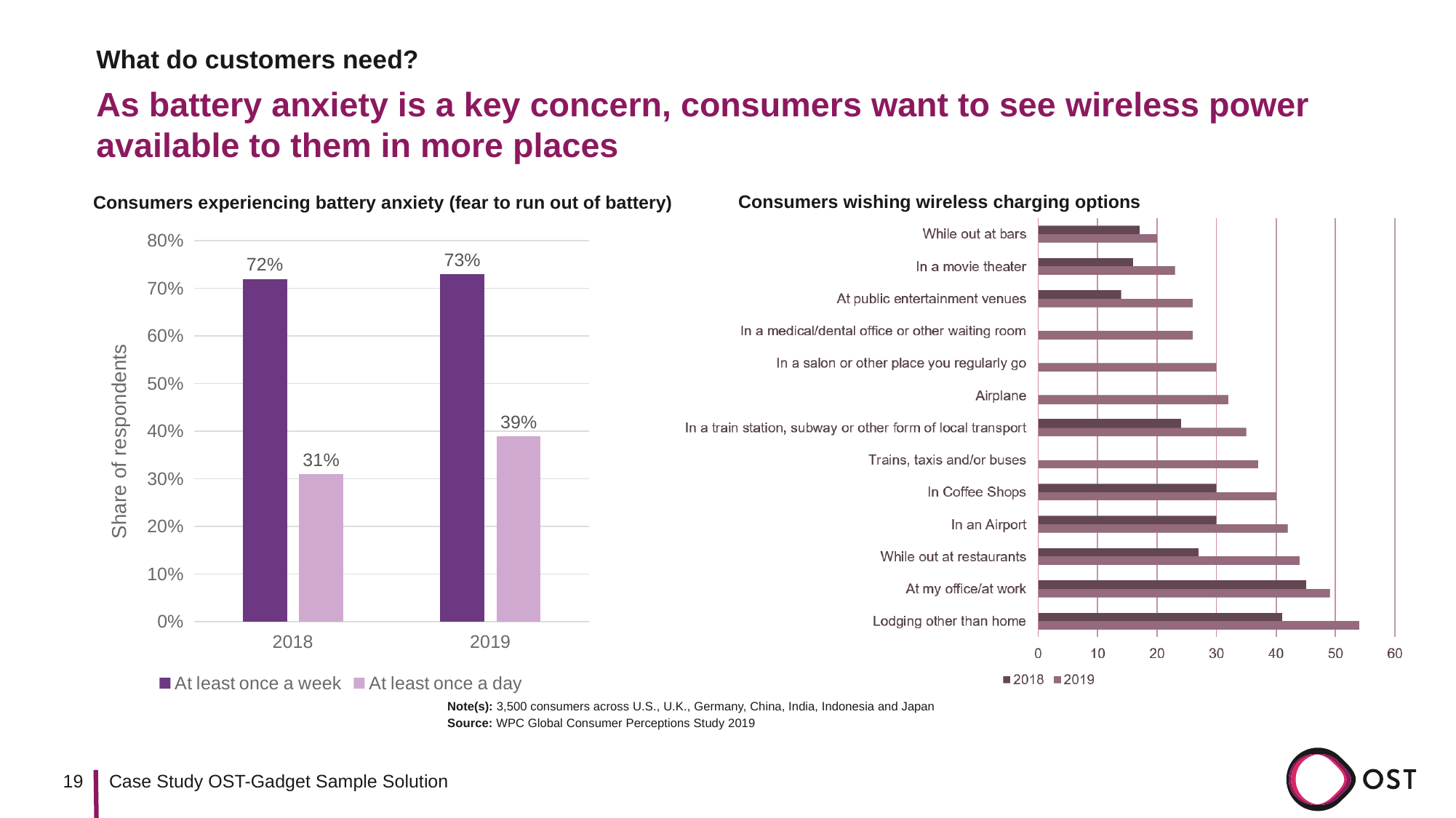
In the 'Consumers experiencing battery anxiety' chart, what is the value for 'At least once a week' in 2018? 72% What kind of chart is 'Consumers wishing wireless charging options'? Bar chart In the 'Consumers experiencing battery anxiety' chart, what is the value for 'At least once a day' in 2019? 39% In the 'Consumers experiencing battery anxiety' chart, what is the label of the vertical axis? Share of respondents In the 'Consumers wishing wireless charging options' chart, is the 2018 value for 'While out at bars' greater or less than 20? less In the 'Consumers wishing wireless charging options' chart, how many categories are shown? 13 In the 'Consumers experiencing battery anxiety' chart, which series has the higher value in 2019? At least once a week In the 'Consumers experiencing battery anxiety' chart, how many series does the legend list? 2 In the 'Consumers experiencing battery anxiety' chart, what is the difference between 'At least once a week' and 'At least once a day' in 2018? 41 percentage points In the 'Consumers wishing wireless charging options' chart, which category has the highest 2019 value? Lodging other than home In the 'Consumers wishing wireless charging options' chart, is the 2019 value for 'At my office/at work' greater or less than 40? greater In the 'Consumers experiencing battery anxiety' chart, by how much did 'At least once a day' change from 2018 to 2019? 8 percentage points